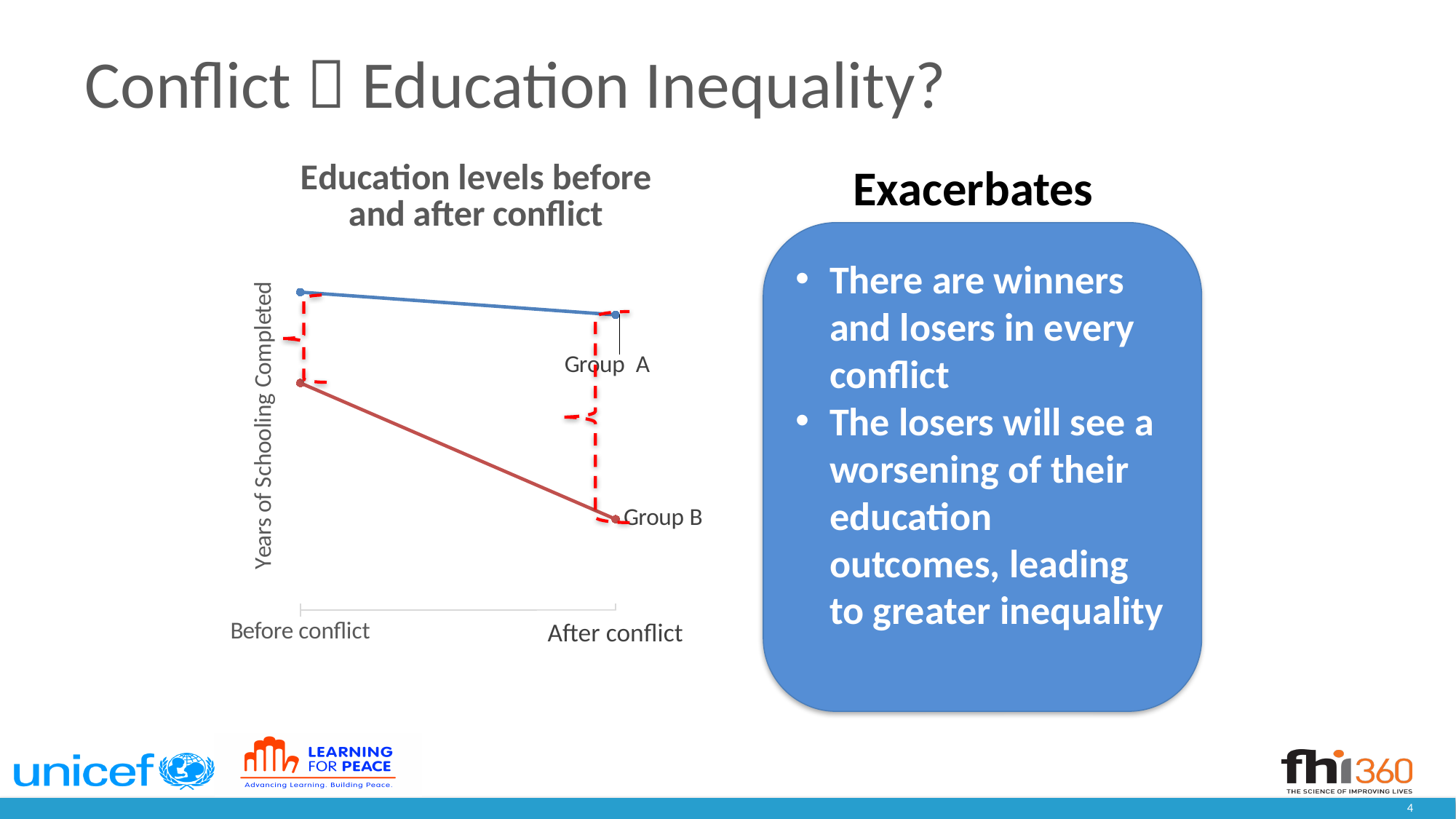
What is the label on the vertical axis of the chart? Years of Schooling Completed Which group shows the larger drop in years of schooling completed from before to after conflict? Group B Which group has the higher years of schooling completed before conflict? Group A What is the title of the chart? Education levels before and after conflict Which group has the highest years of schooling completed after conflict? Group A Does the line for Group A rise or fall from before conflict to after conflict? Fall How many points are shown along the x axis of the chart? 2 What kind of chart is shown on the slide? Line chart Does the line for Group B rise or fall from before conflict to after conflict? Fall How many groups (series) are plotted on the chart? 2 Which group has the lower years of schooling completed after conflict? Group B